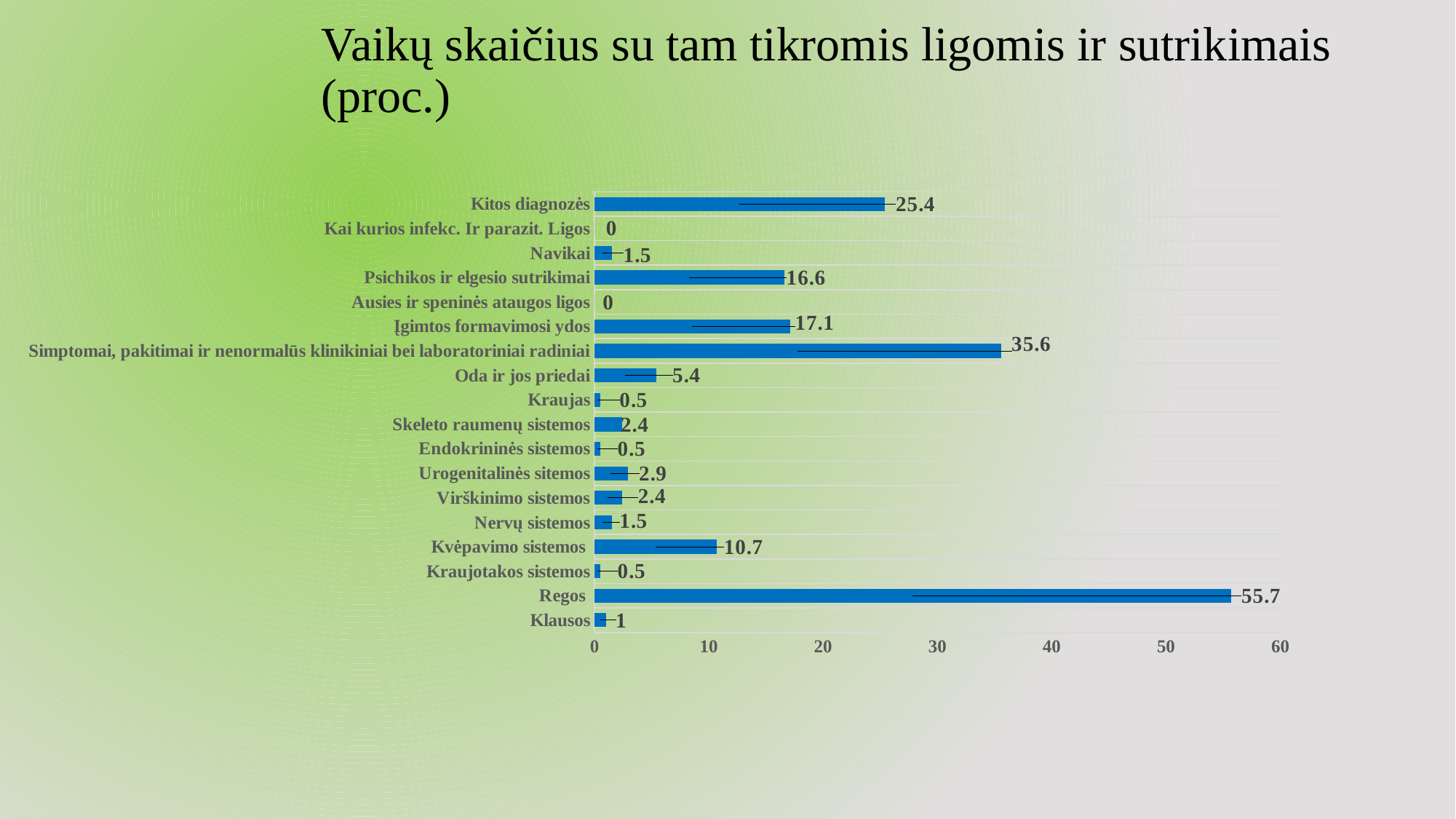
Which category has the highest value? Regos What is the difference between the values for Regos and Simptomai, pakitimai ir nenormalūs klinikiniai bei laboratoriniai radiniai? 20.1 What is the value for Regos? 55.7 What is the value for Psichikos ir elgesio sutrikimai? 16.6 What is the value for Oda ir jos priedai? 5.4 What is the difference between the values for Kitos diagnozės and Įgimtos formavimosi ydos? 8.3 How many categories are shown in the chart? 18 Is the value for Kitos diagnozės greater or less than 20? greater What kind of chart is shown on the slide? Bar chart What is the value for Kvėpavimo sistemos? 10.7 Which is larger, the value for Įgimtos formavimosi ydos or Psichikos ir elgesio sutrikimai? Įgimtos formavimosi ydos What is the title of the chart? Vaikų skaičius su tam tikromis ligomis ir sutrikimais (proc.)